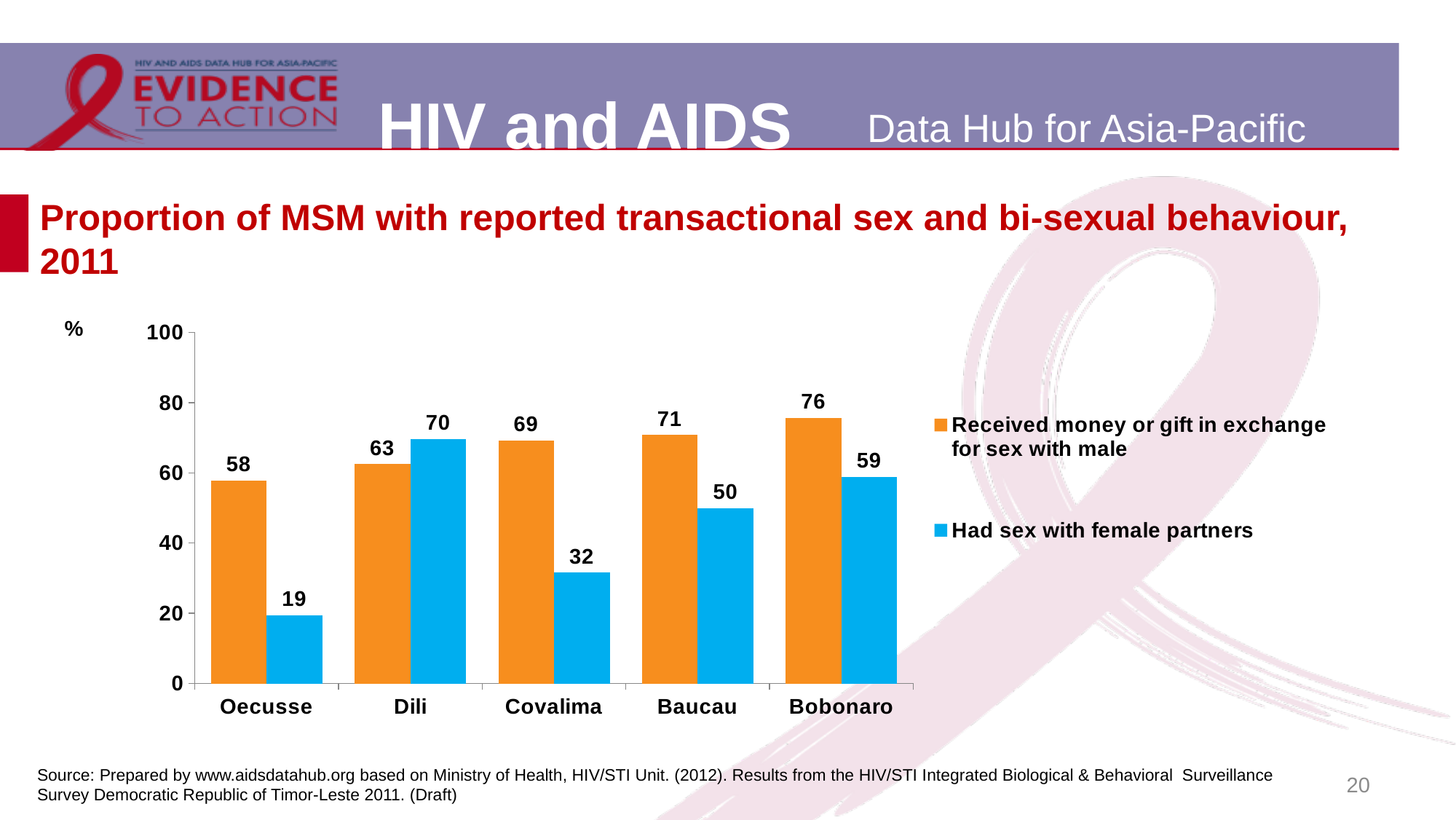
What is the value for 'Had sex with female partners' in Bobonaro? 59 Which district has the highest value for 'Received money or gift in exchange for sex with male'? Bobonaro What is the value for 'Had sex with female partners' in Covalima? 32 How many districts are shown on the x axis? 5 What is the value for 'Received money or gift in exchange for sex with male' in Oecusse? 58 In Dili, which series has the larger value: 'Received money or gift in exchange for sex with male' or 'Had sex with female partners'? Had sex with female partners What kind of chart is shown on the slide? Bar chart Which colour represents 'Had sex with female partners' in the chart? Blue What is the difference between the two series values in Oecusse? 39 Which district has the lowest value for 'Had sex with female partners'? Oecusse How many series does the legend list? 2 What is the difference between 'Received money or gift in exchange for sex with male' in Bobonaro and in Dili? 13